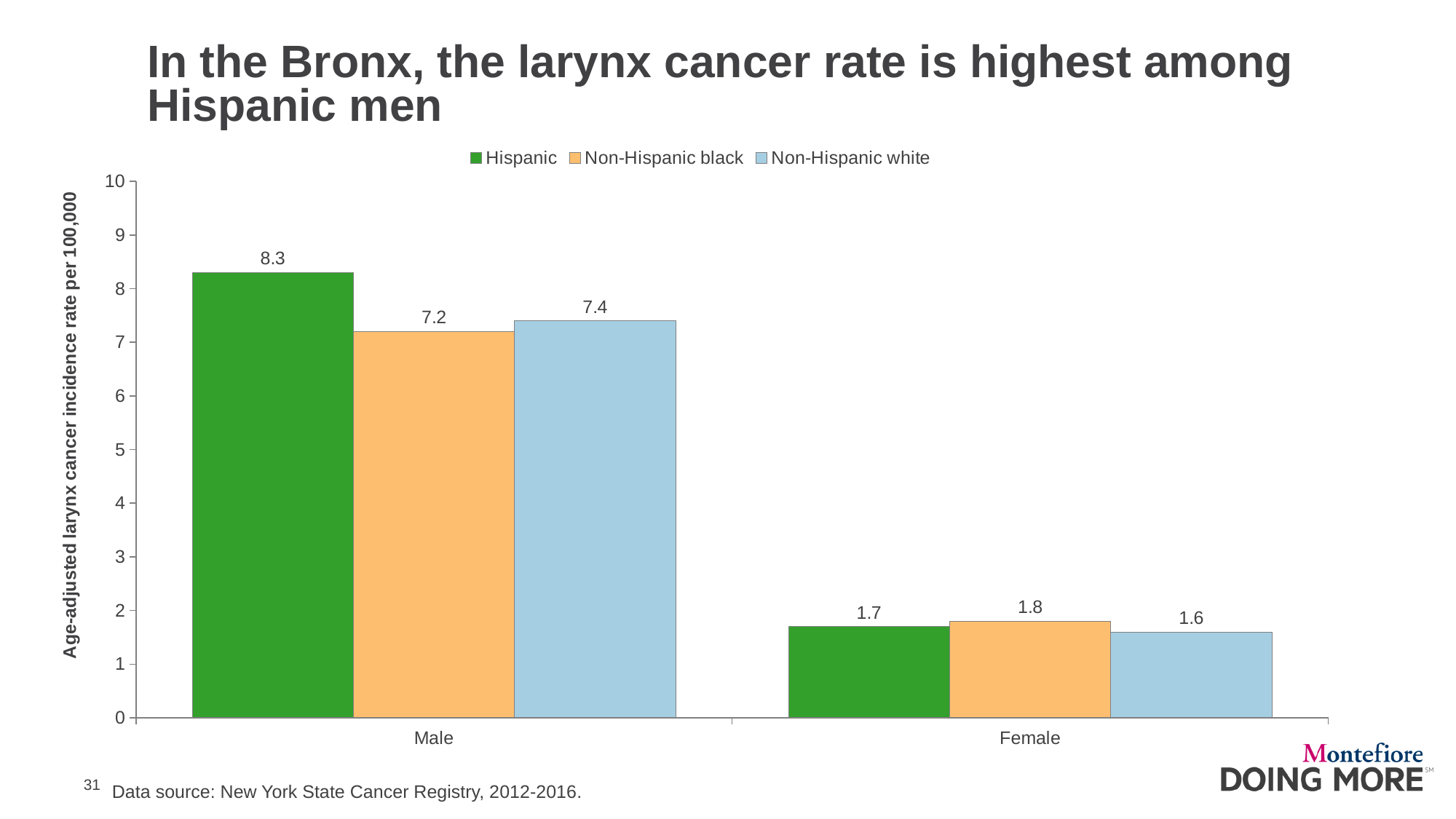
Which group has the highest larynx cancer incidence rate among males? Hispanic Is the value for Non-Hispanic black males greater or less than 8? less What is the label of the vertical axis? Age-adjusted larynx cancer incidence rate per 100,000 What is the difference between the Hispanic male rate and the Non-Hispanic black male rate? 1.1 Which is larger, the Hispanic male rate or the Non-Hispanic white male rate? Hispanic male rate What is the difference between the Non-Hispanic white male rate and the Non-Hispanic white female rate? 5.8 What is the larynx cancer incidence rate for Non-Hispanic black females? 1.8 What is the larynx cancer incidence rate for Hispanic males? 8.3 Which group has the lowest larynx cancer incidence rate among females? Non-Hispanic white What kind of chart is shown on the slide? Bar chart How many series does the legend list? 3 What is the larynx cancer incidence rate for Non-Hispanic white males? 7.4